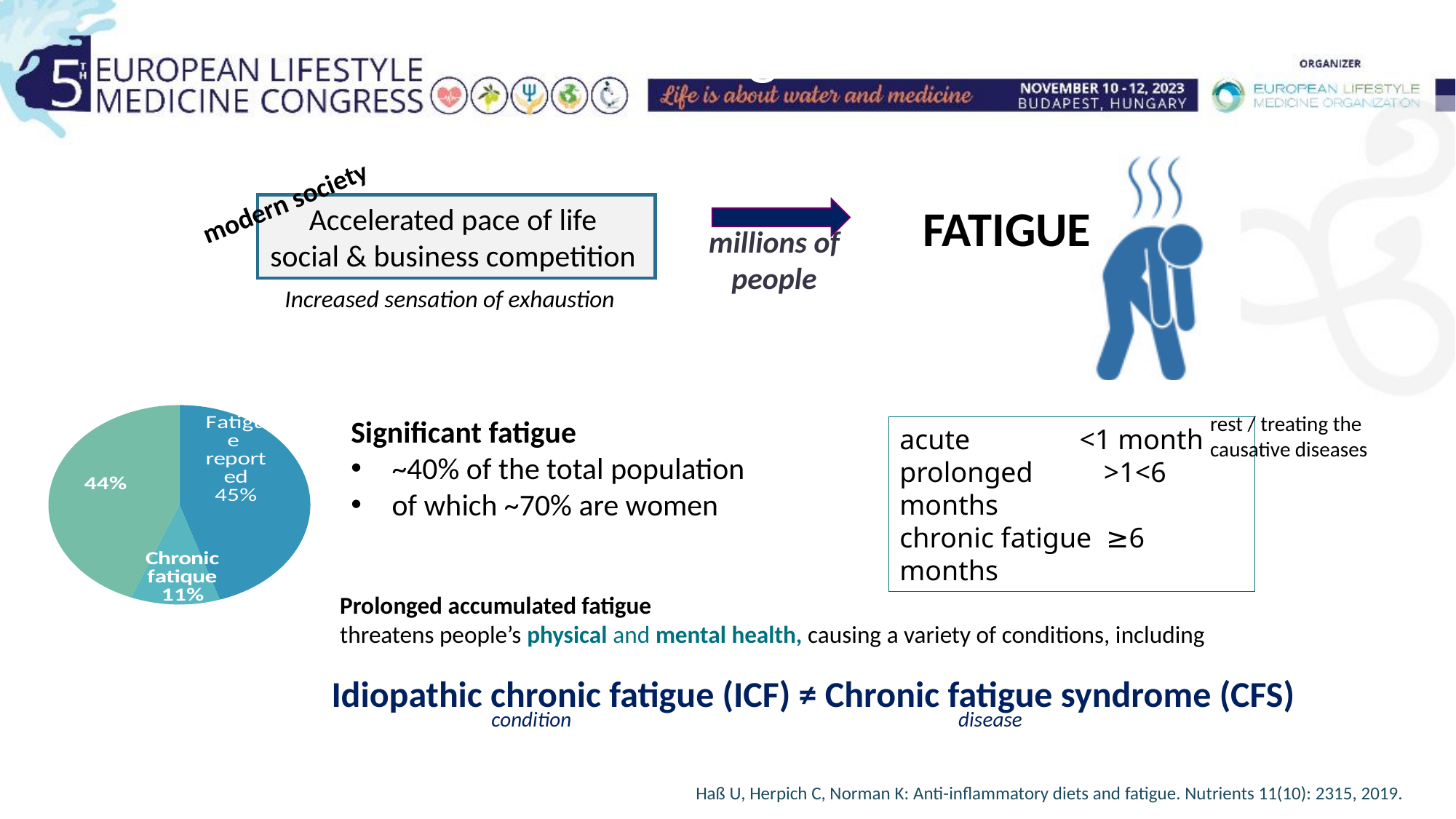
What is the combined share of the "Fatigue reported" and "Chronic fatigue" slices? 56% Is the "Chronic fatigue" slice greater or less than 20% of the pie? less What kind of chart is shown on the slide? pie chart What percentage is shown on the green slice of the pie chart? 44% What share of the pie is labelled "Fatigue reported"? 45% What is the difference in percentage points between the "Fatigue reported" slice and the "Chronic fatigue" slice? 34 How many slices does the pie chart have? 3 Which is larger in the pie chart, the "Fatigue reported" slice or the "Chronic fatigue" slice? Fatigue reported What colour is the "Chronic fatigue" slice of the pie chart? blue Which labelled slice of the pie chart is the largest? Fatigue reported Which labelled slice of the pie chart is the smallest? Chronic fatigue What share of the pie is labelled "Chronic fatigue"? 11%